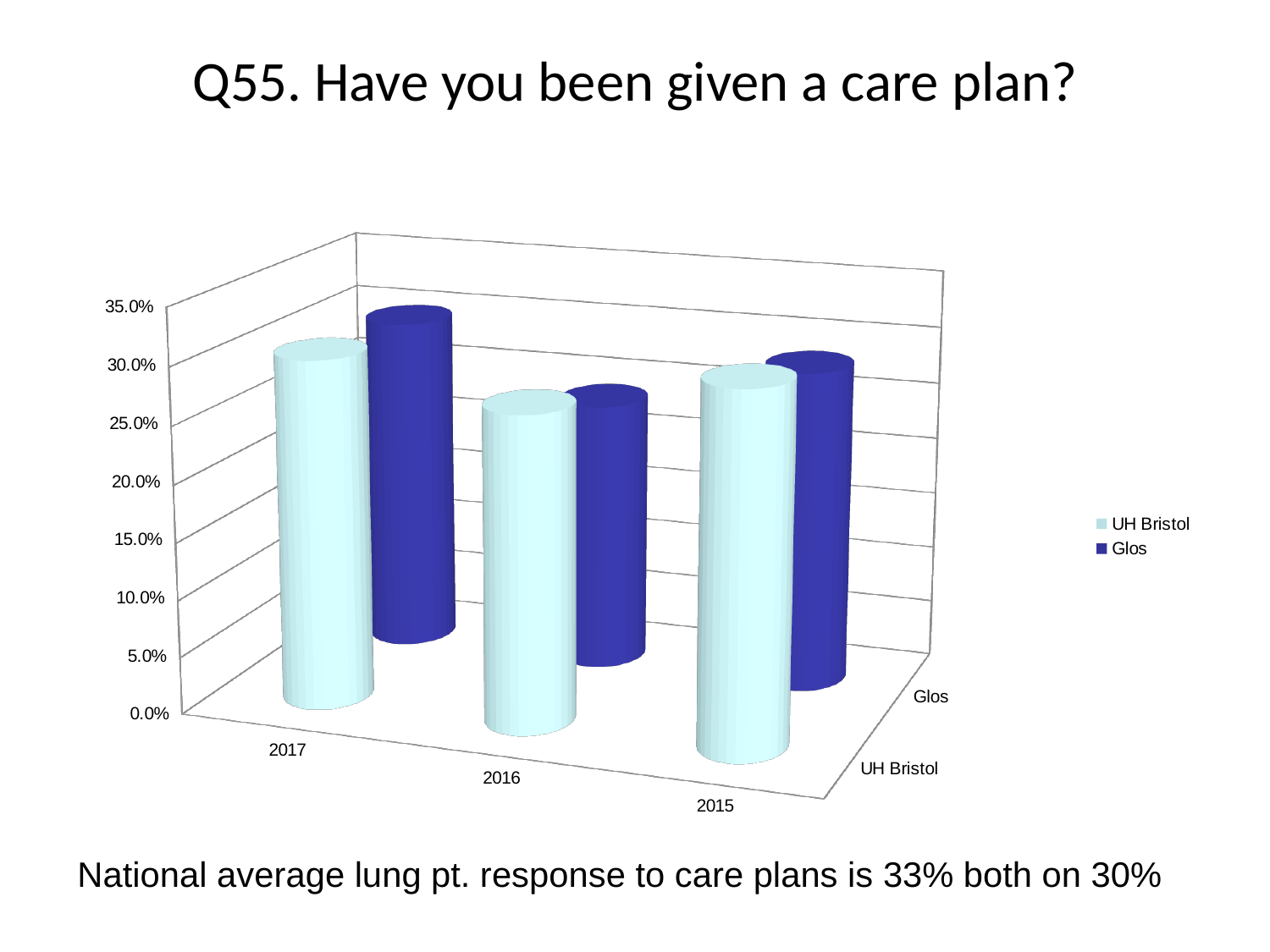
Is the value for UH Bristol in 2015 greater or less than 20.0%? greater What are the two series named in the legend? UH Bristol and Glos How many years are shown on the x axis of the chart? 3 What kind of chart is shown on the slide? bar chart How many series does the legend list? 2 Is the value for UH Bristol in 2017 greater or less than 20.0%? greater Is the value for Glos in 2017 greater or less than 35.0%? less What is the title of the chart? Q55. Have you been given a care plan? Which is larger for UH Bristol: the value in 2017 or the value in 2016? 2017 Which year has the lowest value for Glos? 2016